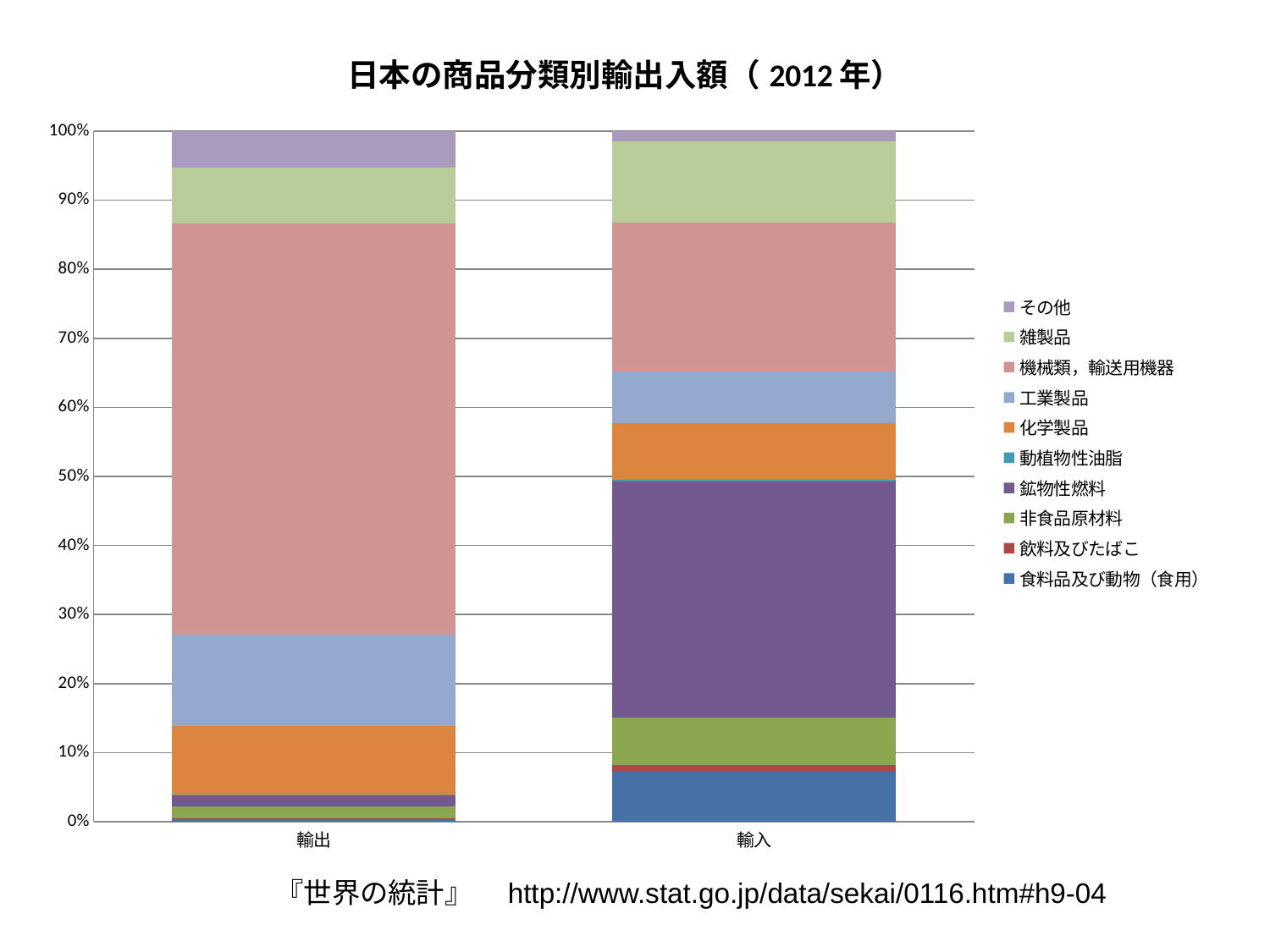
What is the total height of the 輸出 stacked bar? 100% Is the share of 鉱物性燃料 in the 輸入 bar greater or less than 20%? greater What is the title of the chart? 日本の商品分類別輸出入額（2012年） Which bar has the larger share of 機械類，輸送用機器, 輸出 or 輸入? 輸出 Which series takes the largest share of the 輸出 bar? 機械類，輸送用機器 What kind of chart is shown on the slide? stacked bar chart Which series takes the largest share of the 輸入 bar? 鉱物性燃料 Which bar has the larger share of 鉱物性燃料, 輸出 or 輸入? 輸入 What are the two categories on the x axis? 輸出 and 輸入 Is the share of 機械類，輸送用機器 in the 輸出 bar greater or less than 50%? greater How many bars (categories) are plotted on the x axis? 2 How many series does the legend list? 10